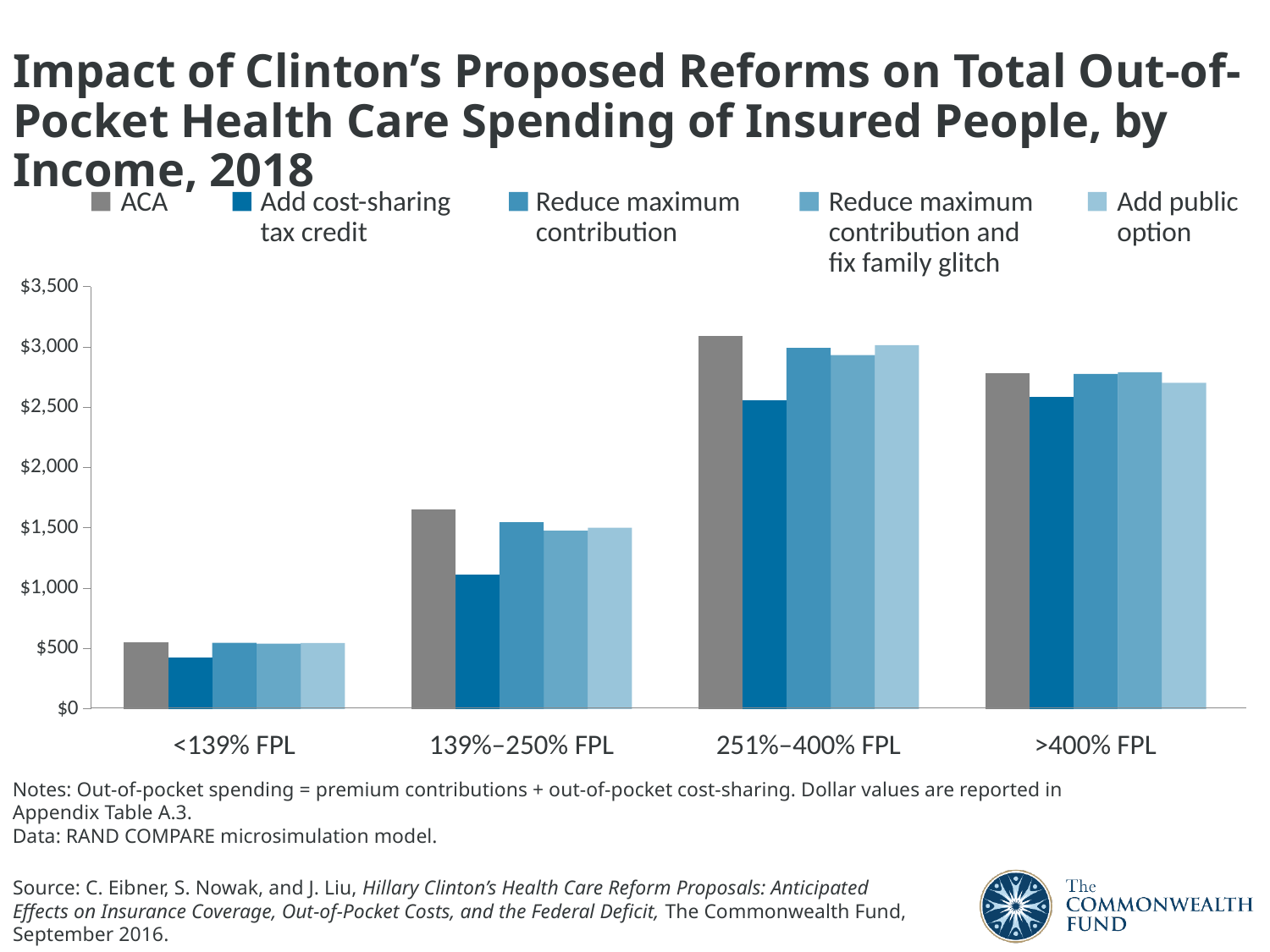
Is the Add cost-sharing tax credit value for 139%–250% FPL greater or less than $1,500? less How many income groups are shown on the x axis? 4 Within the 139%–250% FPL group, which series has the lowest value? Add cost-sharing tax credit Is the ACA value for 139%–250% FPL greater or less than $1,500? greater What colour are the ACA bars? gray Which income group has the lowest ACA value? <139% FPL Is the Add cost-sharing tax credit value for <139% FPL greater or less than $500? less For 251%–400% FPL, which is larger: the ACA value or the Add cost-sharing tax credit value? ACA Which income group has the highest ACA value? 251%–400% FPL What kind of chart is shown on the slide? bar chart How many series does the legend list? 5